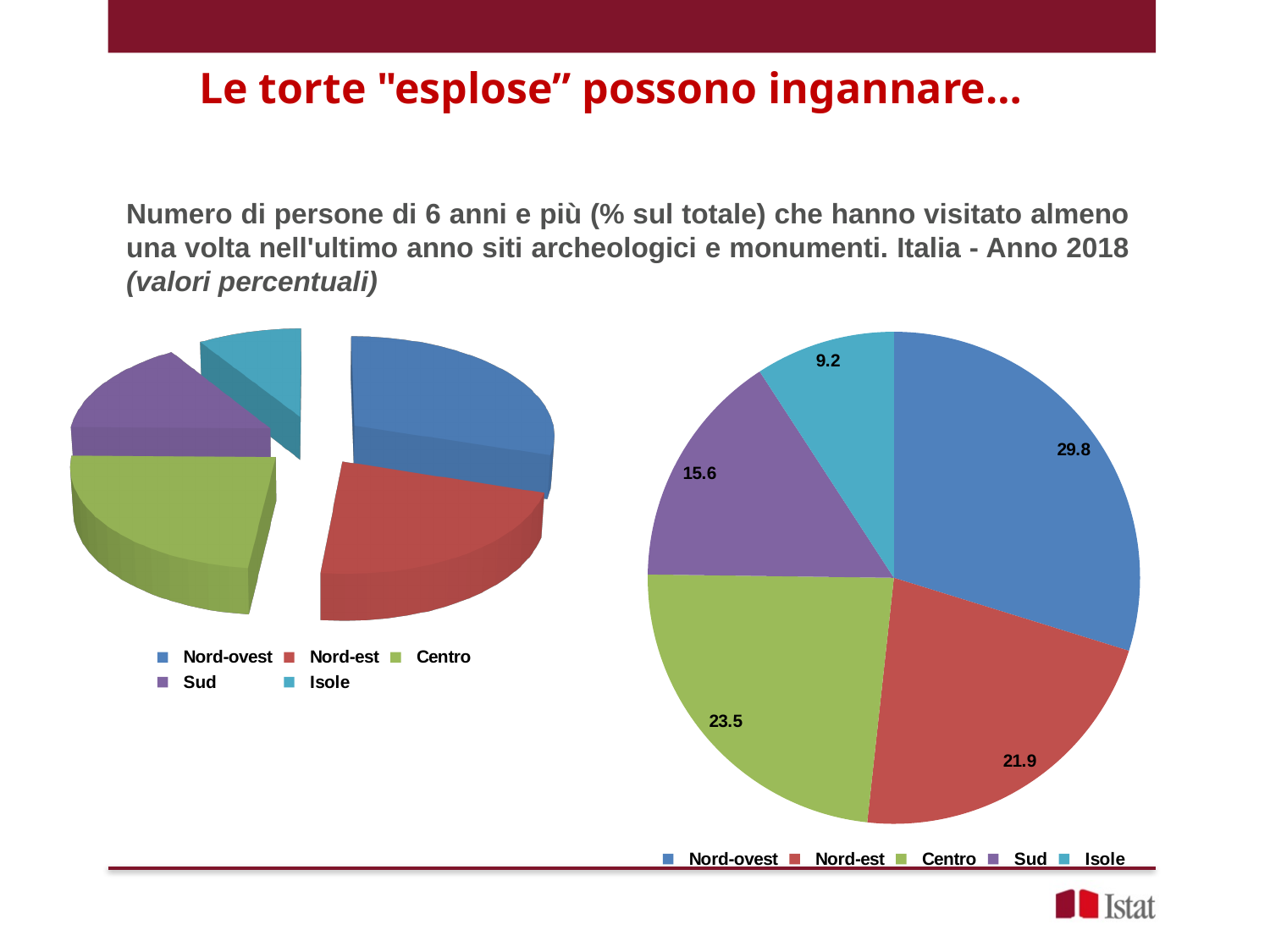
In the pie chart on the right, what is the difference between the values for Nord-ovest and Nord-est? 7.9 In the pie chart on the right, what is the value for Centro? 23.5 In the pie chart on the right, what is the value for Isole? 9.2 In the pie chart on the right, which is larger, the value for Centro or the value for Nord-est? Centro In the pie chart on the right, which colour is used for the Sud slice? Purple What kind of chart is the chart on the left of the slide? Pie chart How many entries does the legend of the chart on the left list? 5 In the pie chart on the right, which category has the largest slice? Nord-ovest How many categories does the pie chart on the right show? 5 In the pie chart on the right, what is the value for Sud? 15.6 In the pie chart on the right, which category has the smallest slice? Isole In the pie chart on the right, what is the value for Nord-ovest? 29.8